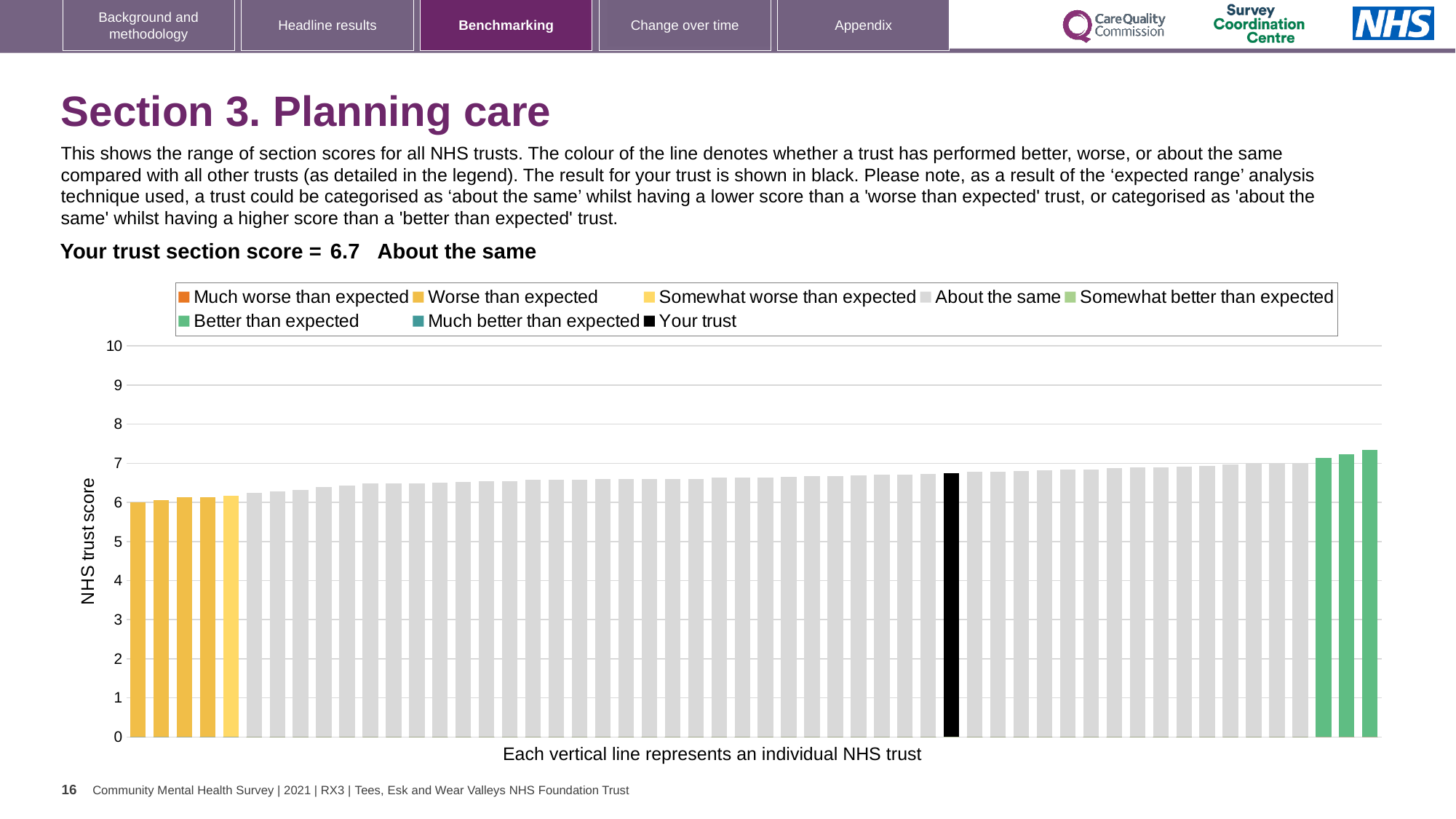
Is the value of the tallest bar greater or less than 7? greater What is the highest value shown on the vertical axis? 10 What is the section score for your trust shown on the slide? 6.7 Which category is your trust placed in for this section? About the same Do the bar values rise or fall from left to right along the x axis? rise Is the value of the black bar (your trust) greater or less than 6? greater Is the value of the shortest bar greater or less than 5? greater What kind of chart is shown on the slide? bar chart How many bars are coloured green for 'Better than expected'? 3 How many entries does the chart legend list? 8 What is the label on the vertical axis of the chart? NHS trust score